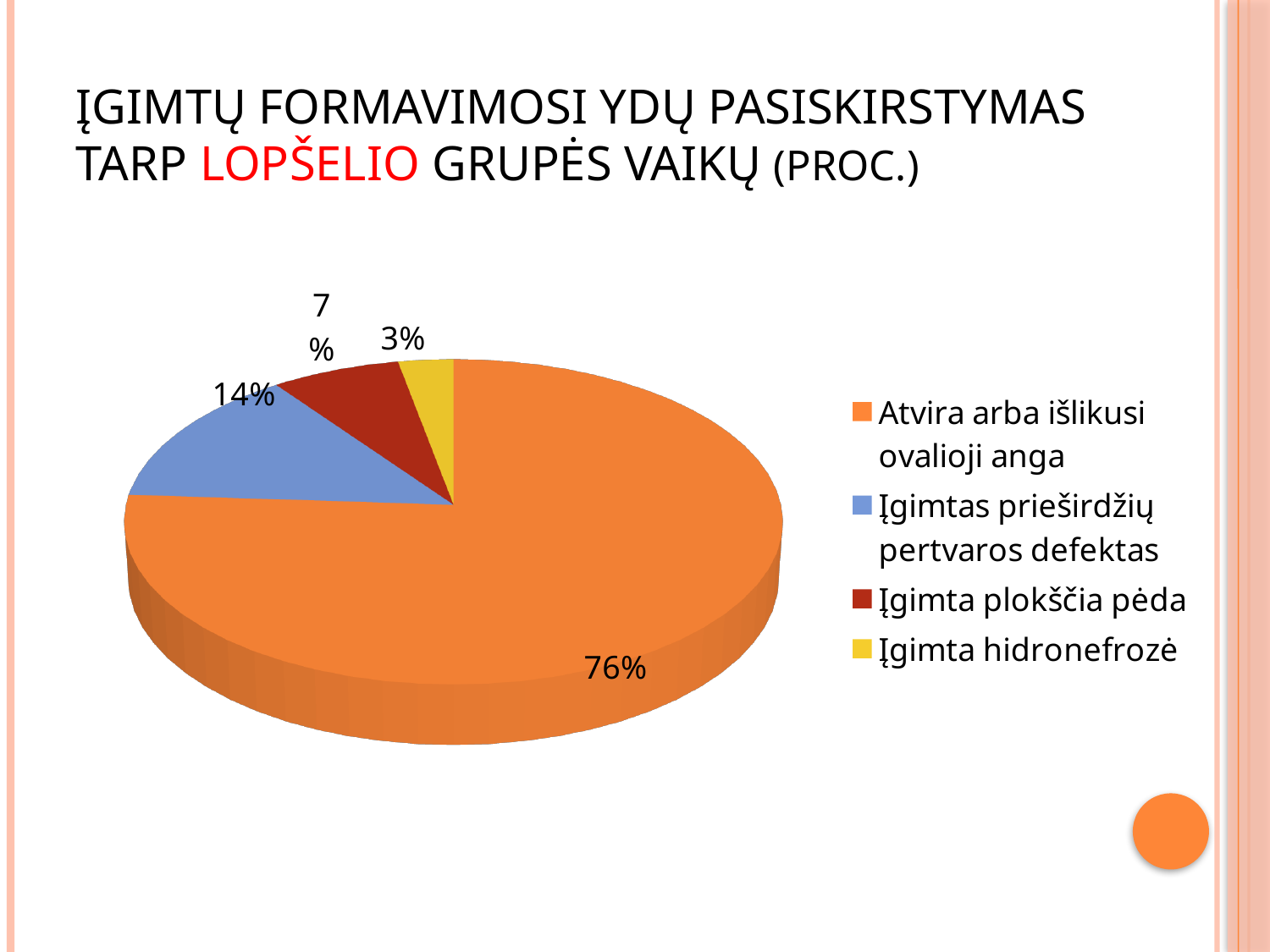
Which word in the slide title is shown in red? LOPŠELIO What is the difference in percentage points between 'Atvira arba išlikusi ovalioji anga' and 'Įgimtas prieširdžių pertvaros defektas'? 62 What share of the pie does 'Įgimtas prieširdžių pertvaros defektas' have? 14% Which is larger: the slice for 'Įgimta plokščia pėda' or the slice for 'Įgimta hidronefrozė'? Įgimta plokščia pėda Which category has the smallest slice of the pie? Įgimta hidronefrozė What colour is the slice for 'Įgimtas prieširdžių pertvaros defektas'? blue Which category has the largest slice of the pie? Atvira arba išlikusi ovalioji anga How many categories does the pie chart show? 4 What share of the pie does 'Įgimta hidronefrozė' have? 3% What share of the pie does 'Atvira arba išlikusi ovalioji anga' have? 76% What kind of chart is shown on the slide? pie chart